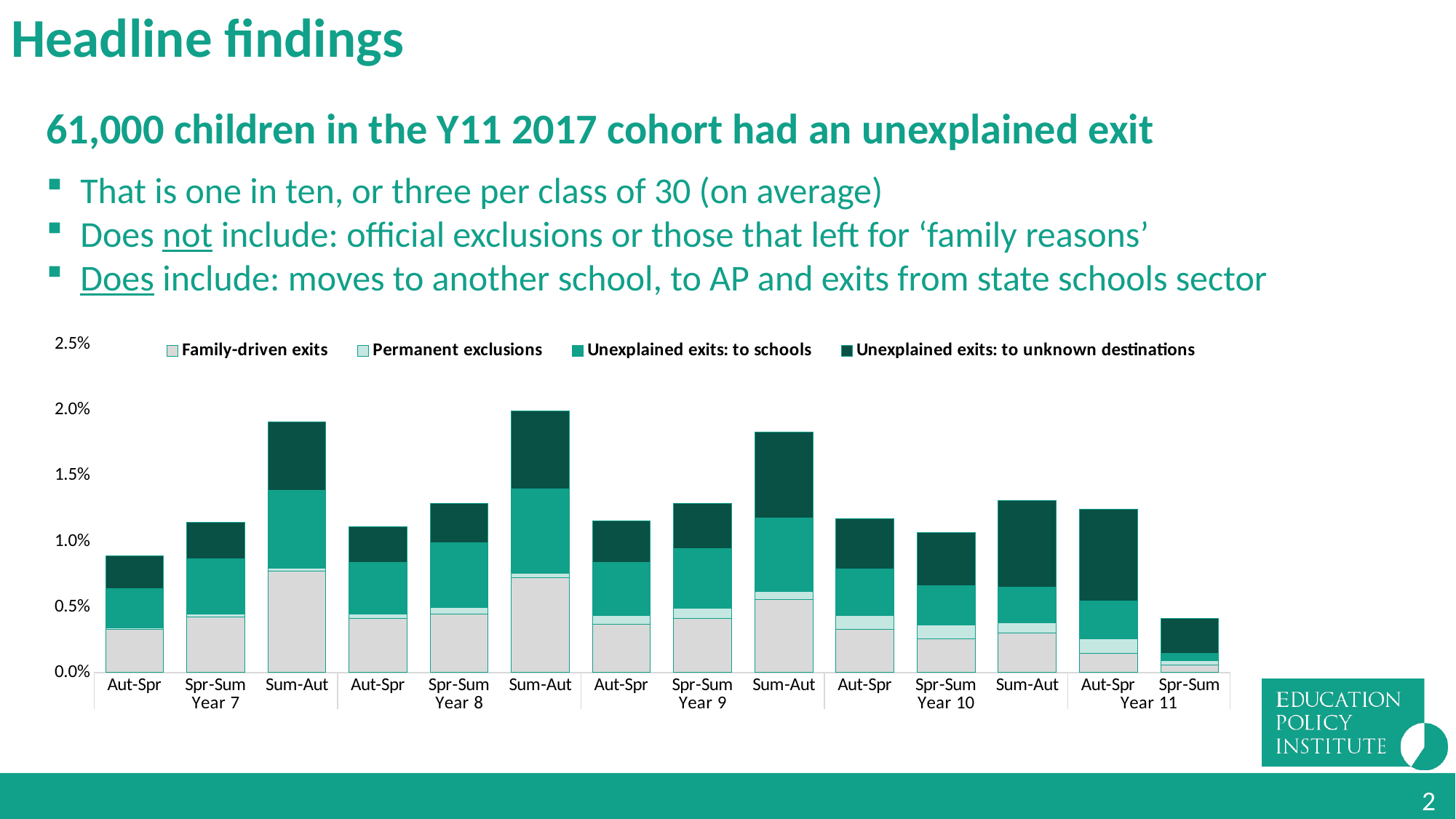
How many series does the chart legend list? 4 Which series in the legend is shown in light grey? Family-driven exits Which bar has the lowest total in the chart? Spr-Sum Year 11 How many bars (term periods) are plotted in the chart? 14 What is the highest value shown on the vertical axis of the chart? 2.5% Which has the larger total: Sum-Aut Year 9 or Aut-Spr Year 7? Sum-Aut Year 9 Is the total for Aut-Spr Year 7 greater or less than 1.0%? less Is the total for Sum-Aut Year 7 greater or less than 1.5%? greater What kind of chart is shown on the slide? Stacked bar chart Is the total for Sum-Aut Year 9 greater or less than 1.5%? greater Which has the larger total: Aut-Spr Year 11 or Spr-Sum Year 11? Aut-Spr Year 11